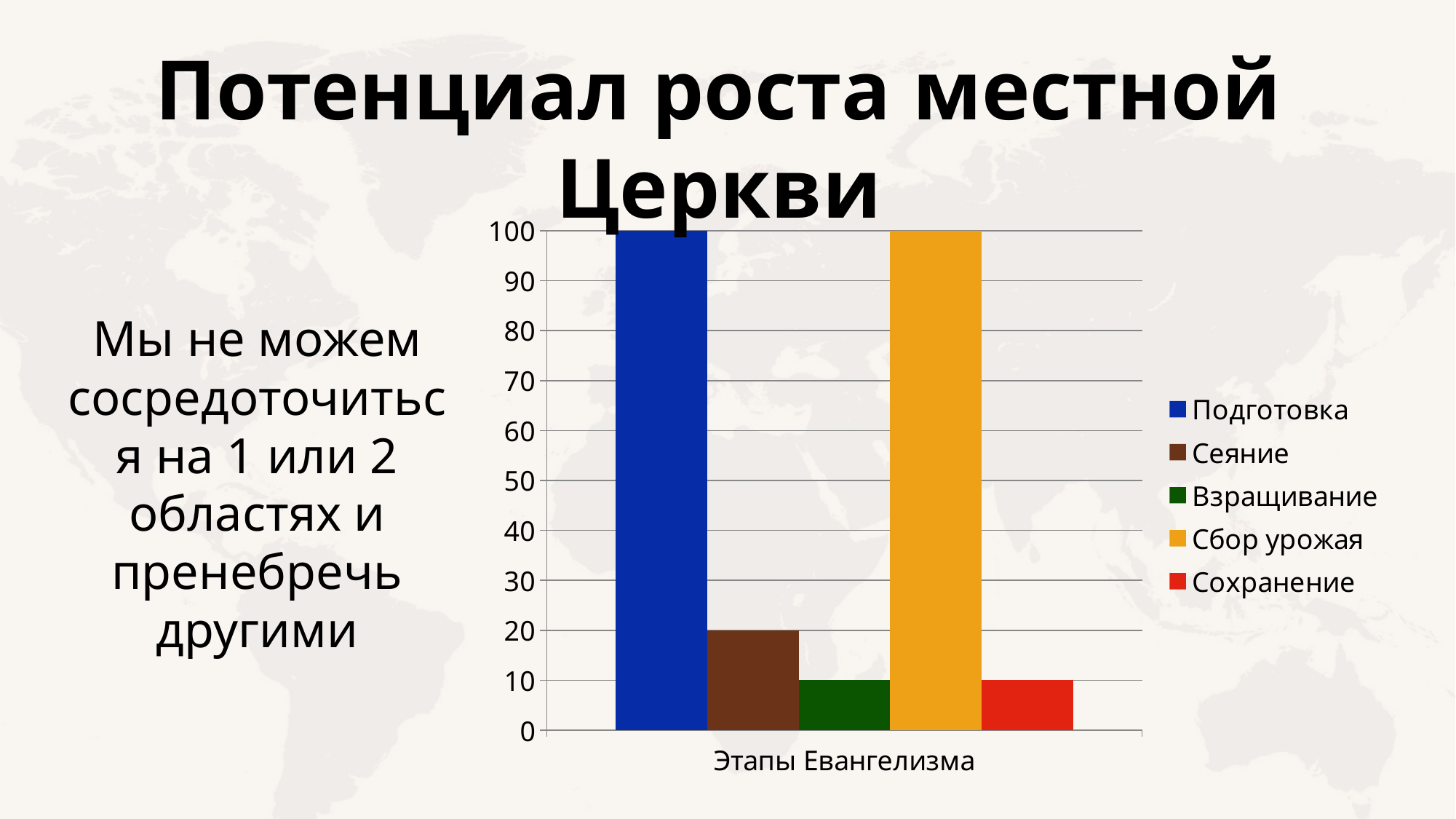
What is the value of the Сохранение bar? 10 What is the value of the Сбор урожая bar? 100 Is the value for Сеяние greater or less than 50? less What is the difference between the values for Сбор урожая and Сохранение? 90 What is the value of the Подготовка bar? 100 What is the value of the Сеяние bar? 20 How many series does the legend list? 5 What is the label on the x axis of the chart? Этапы Евангелизма What is the difference between the values for Сеяние and Взращивание? 10 Which is larger, the value for Подготовка or the value for Сеяние? Подготовка What is the value of the Взращивание bar? 10 What kind of chart is shown on the slide? bar chart